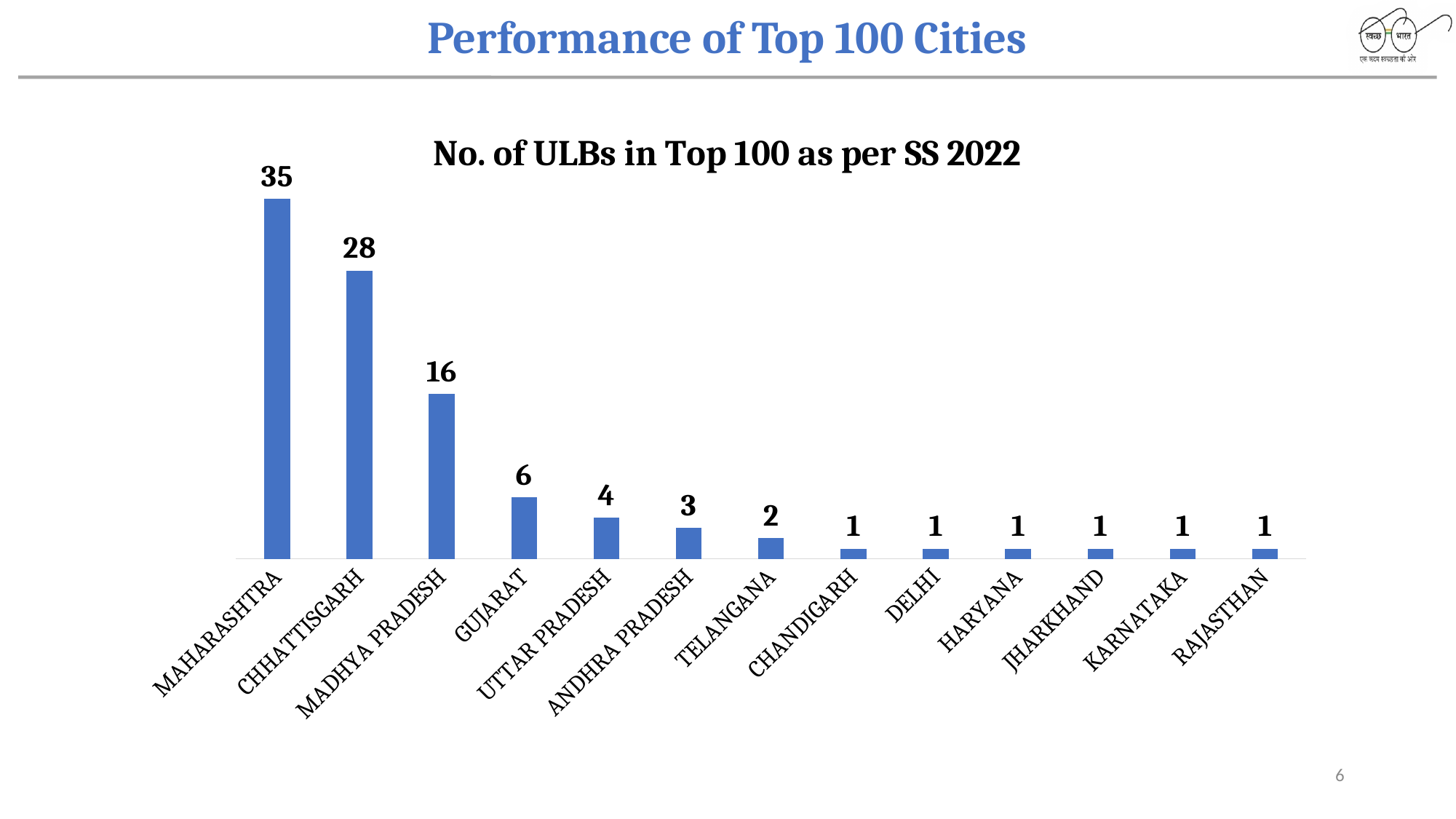
Which state has the highest number of ULBs in the Top 100? Maharashtra Do the values rise or fall from left to right along the x axis? Fall What kind of chart is shown on the slide? Bar chart What is the number of ULBs in the Top 100 for Gujarat? 6 What is the title of the chart? No. of ULBs in Top 100 as per SS 2022 Which has more ULBs in the Top 100, Uttar Pradesh or Andhra Pradesh? Uttar Pradesh What is the difference between the number of ULBs for Chhattisgarh and Madhya Pradesh? 12 What is the number of ULBs in the Top 100 for Telangana? 2 How many states/UTs are shown on the chart? 13 What is the difference between the number of ULBs for Maharashtra and Chhattisgarh? 7 What is the number of ULBs in the Top 100 for Madhya Pradesh? 16 What is the number of ULBs in the Top 100 for Maharashtra? 35